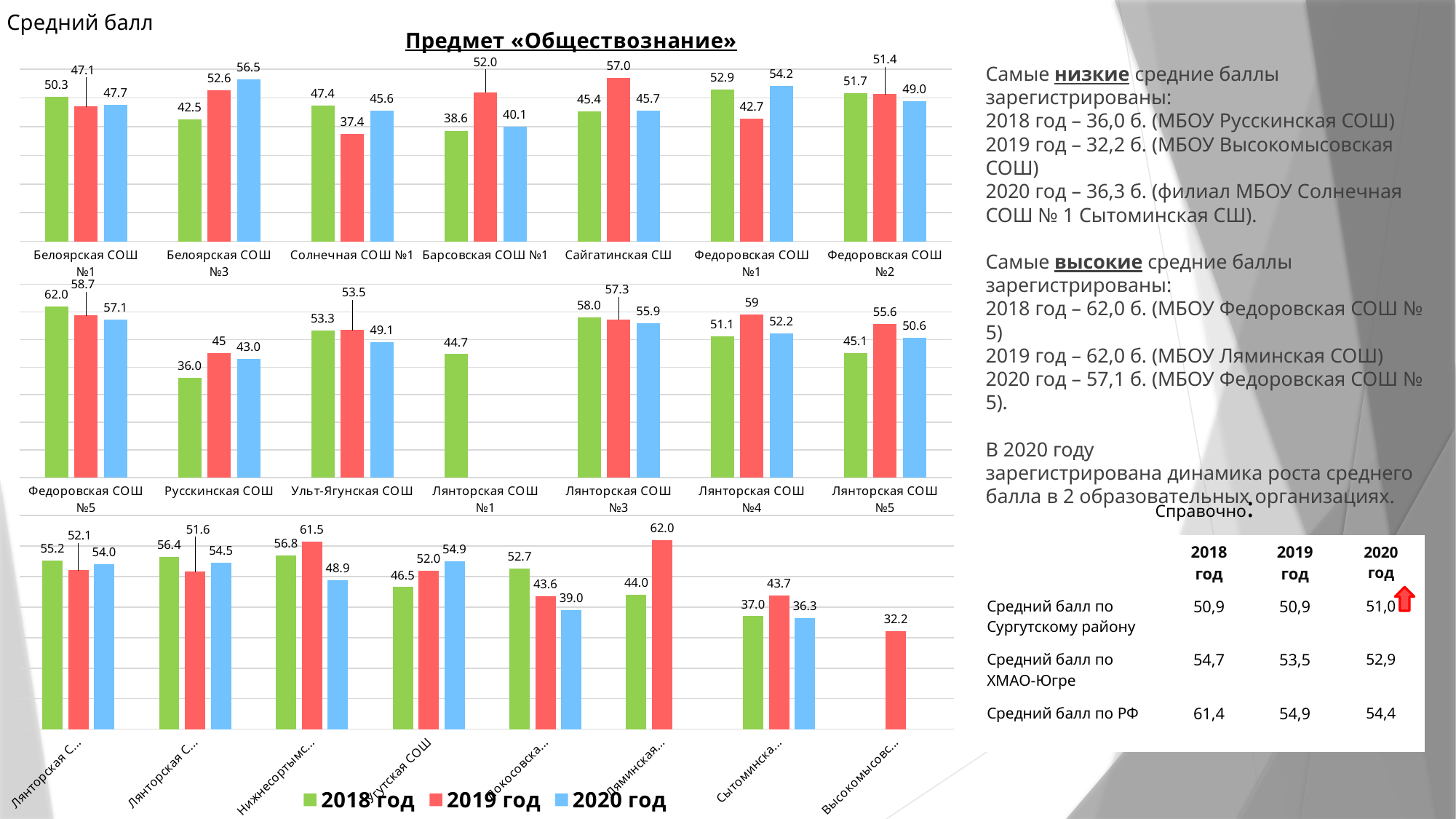
In the top chart, what is the difference between the 2019 год and 2018 год values for Барсовская СОШ №1? 13.4 How many series does the legend list? 3 In the middle chart, what is the 2018 год value for Федоровская СОШ №5? 62.0 How many schools are shown in the top chart? 7 In the top chart, which school has the highest 2019 год value? Сайгатинская СШ In the top chart, what is the 2019 год value for Сайгатинская СШ? 57.0 What kind of chart is used on this slide? Bar chart In the middle chart, which is larger for Лянторская СОШ №4: the 2019 год value or the 2018 год value? 2019 год In the middle chart, which school has the lowest 2018 год value? Русскинская СОШ In the top chart, what is the 2020 год value for Белоярская СОШ №3? 56.5